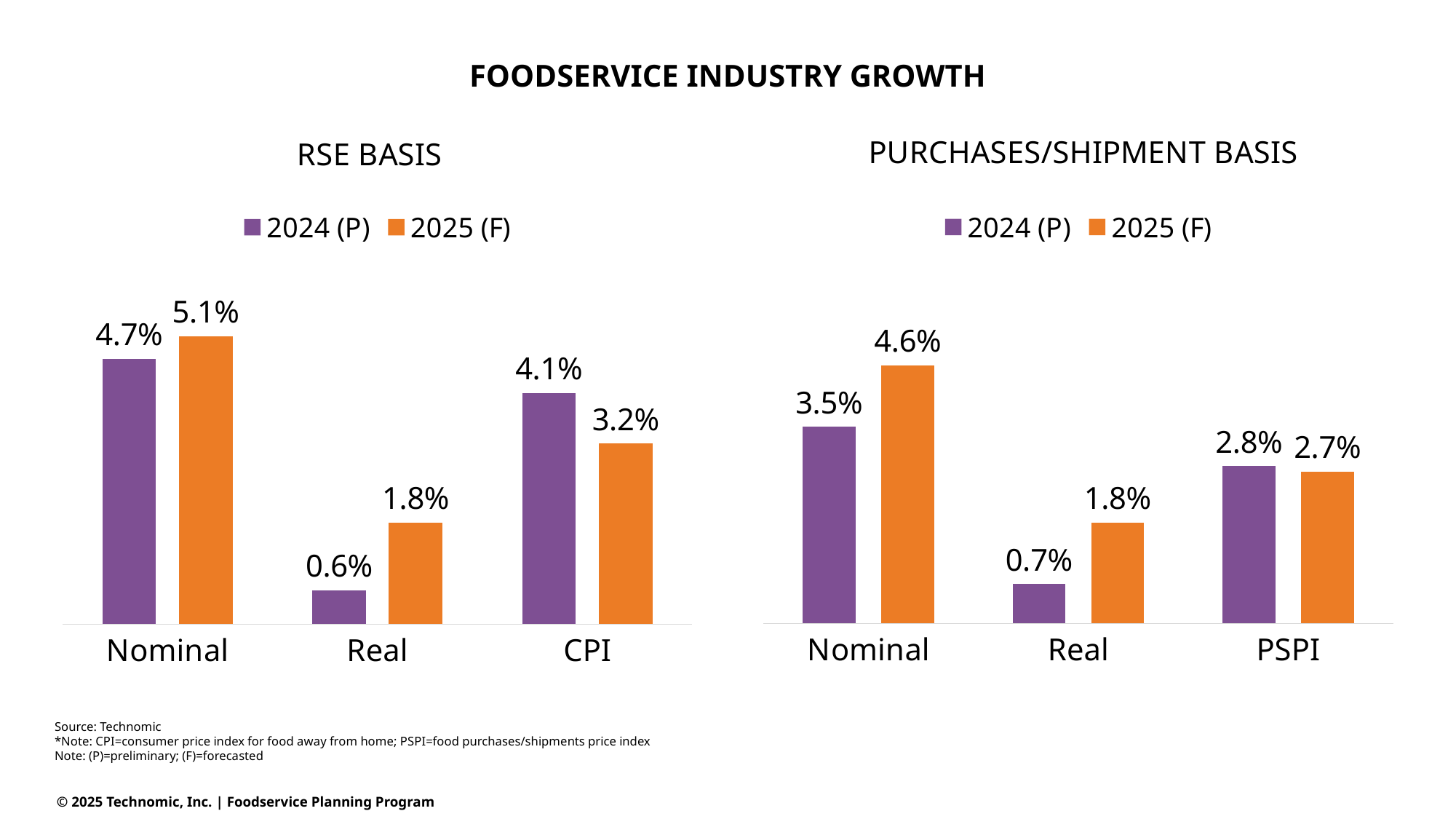
How many series does the legend of the RSE BASIS chart list? 2 In the RSE BASIS chart, what is the 2024 (P) value for Nominal? 4.7% In the PURCHASES/SHIPMENT BASIS chart, what is the 2024 (P) value for PSPI? 2.8% In the RSE BASIS chart, what is the 2025 (F) value for Real? 1.8% In the RSE BASIS chart, which category has the lowest 2024 (P) value? Real In the RSE BASIS chart, which is larger for CPI: the 2024 (P) value or the 2025 (F) value? 2024 (P) In the PURCHASES/SHIPMENT BASIS chart, which category has the highest 2025 (F) value? Nominal How many categories are shown on the x axis of the PURCHASES/SHIPMENT BASIS chart? 3 What kind of chart is the RSE BASIS chart? Bar chart In the PURCHASES/SHIPMENT BASIS chart, what is the difference between the 2025 (F) and 2024 (P) values for Real? 1.1% In the RSE BASIS chart, what is the difference between the 2024 (P) and 2025 (F) values for CPI? 0.9% In the PURCHASES/SHIPMENT BASIS chart, what is the 2025 (F) value for Nominal? 4.6%